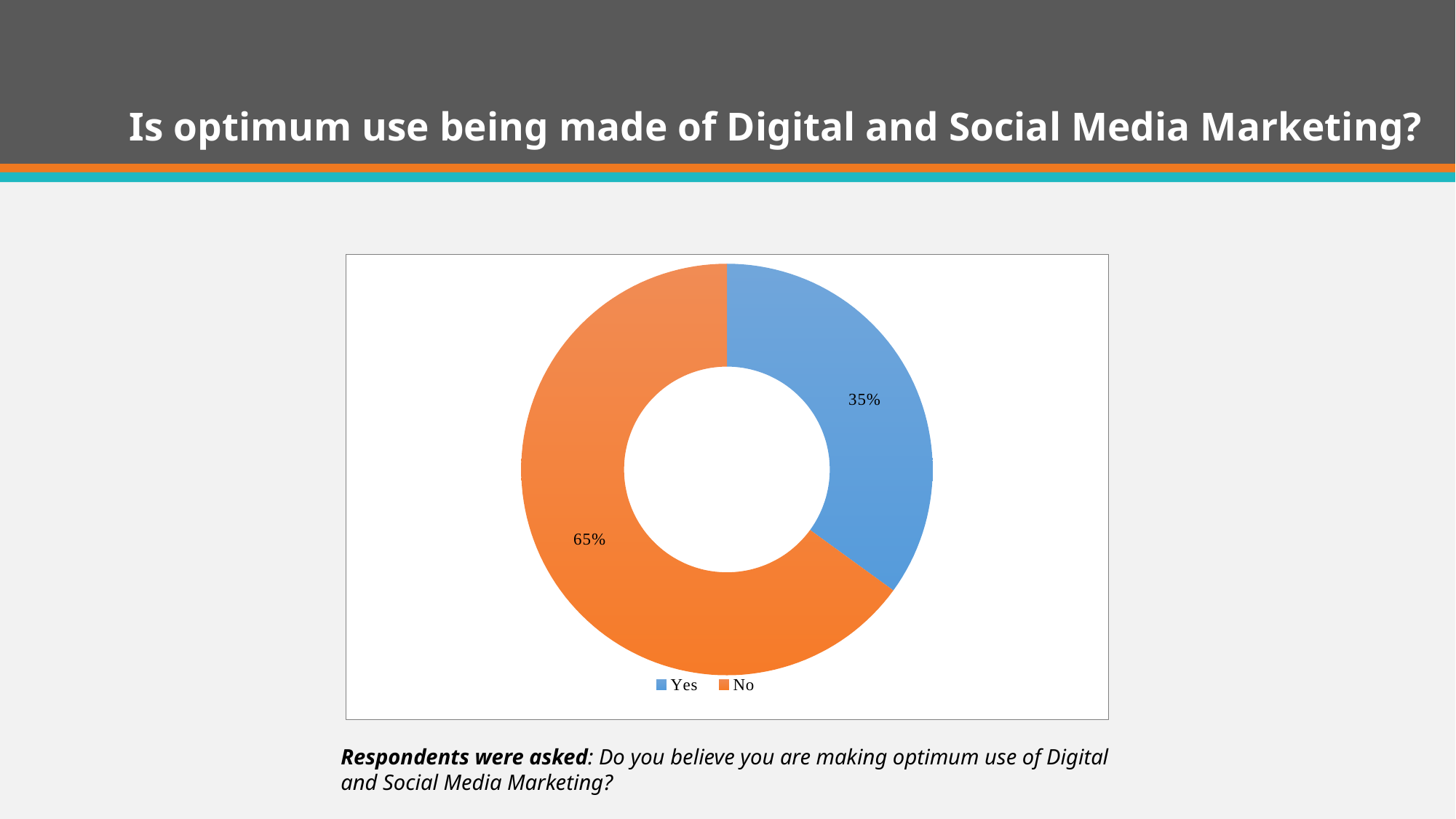
What is the difference in percentage points between the No and Yes shares? 30 How many categories does the chart show? 2 How many entries does the legend list? 2 What percentage of respondents answered Yes? 35% What colour is the Yes slice? Blue What percentage of respondents answered No? 65% What kind of chart is shown on the slide? Doughnut (pie) chart What share of the chart does the Yes slice represent? 35% Which response has the largest share of the chart? No Which is larger, the share for Yes or the share for No? No Which response has the smallest share of the chart? Yes What colour is the No slice? Orange